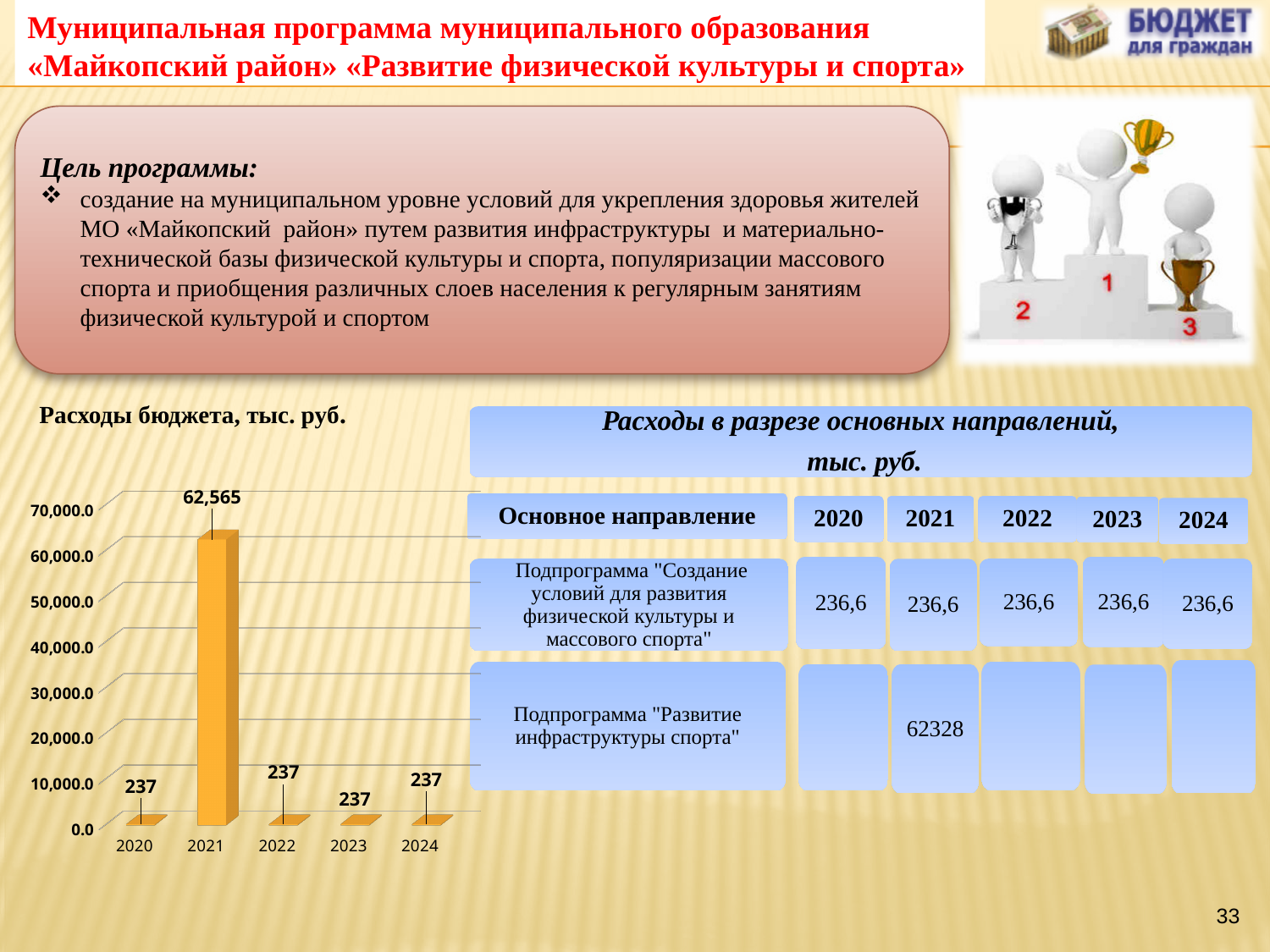
In the chart "Расходы бюджета, тыс. руб.", what is the value for 2021? 62,565 In the chart "Расходы бюджета, тыс. руб.", what is the value for 2024? 237 In the chart "Расходы бюджета, тыс. руб.", is the value for 2021 greater or less than 60,000.0? greater What is the highest value labelled on the vertical axis of the chart "Расходы бюджета, тыс. руб."? 70,000.0 In the chart "Расходы бюджета, тыс. руб.", which year has the highest value? 2021 In the chart "Расходы бюджета, тыс. руб.", which is larger, the value for 2021 or the value for 2023? 2021 In the chart "Расходы бюджета, тыс. руб.", do the values rise or fall from 2021 to 2022? fall In the chart "Расходы бюджета, тыс. руб.", what is the difference between the values for 2021 and 2022? 62,328 What type of chart is shown under the heading "Расходы бюджета, тыс. руб."? bar chart In the chart "Расходы бюджета, тыс. руб.", how many years are shown on the x axis? 5 In the chart "Расходы бюджета, тыс. руб.", what is the value for 2020? 237 In the chart "Расходы бюджета, тыс. руб.", is the value for 2022 greater or less than 10,000.0? less